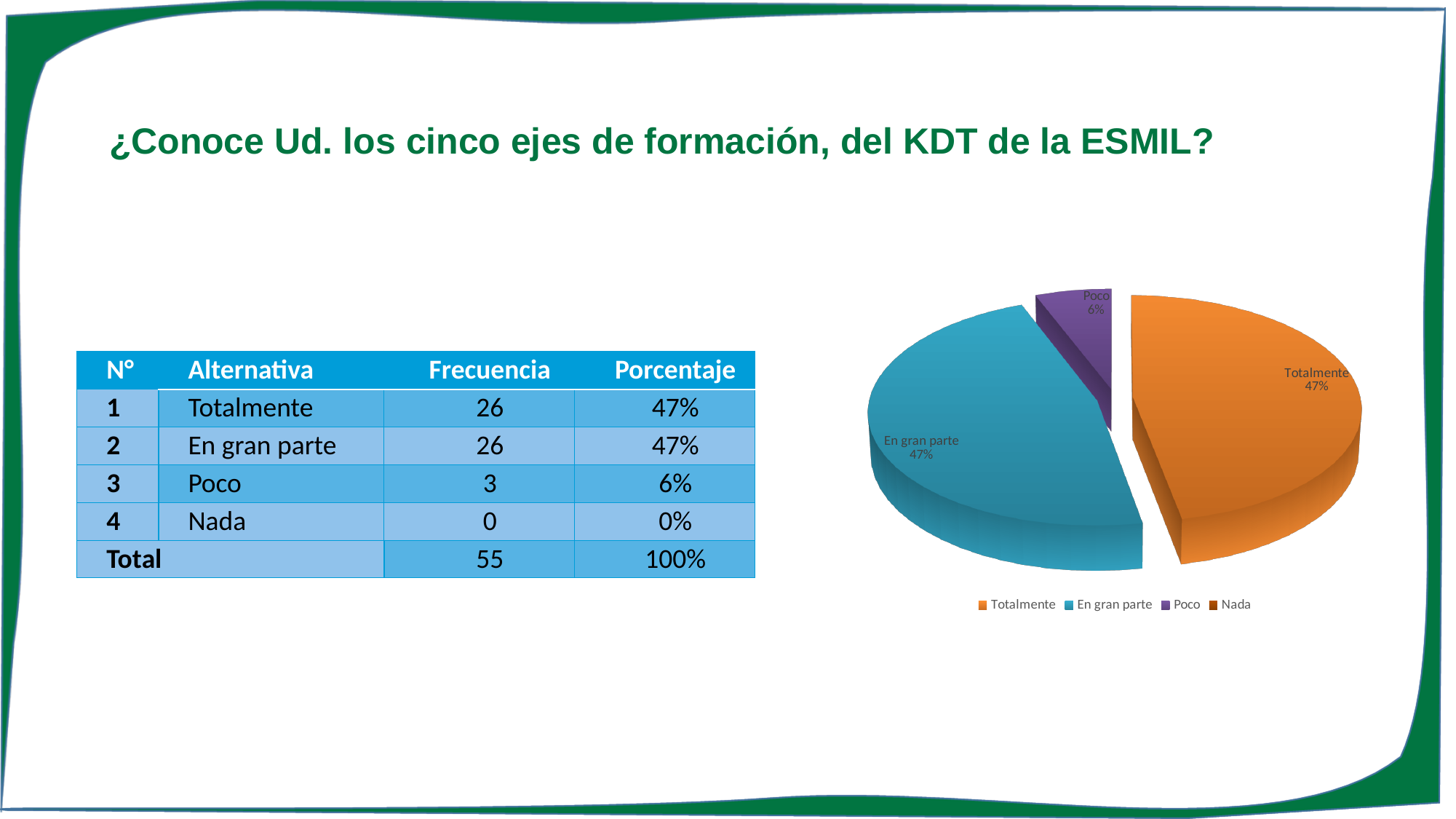
Which category has the smallest visible slice in the pie chart? Poco What is the combined share of Totalmente and En gran parte in the pie chart? 94% What kind of chart is shown on the slide? pie chart How many entries does the pie chart's legend list? 4 What percentage does the pie chart show for Poco? 6% What percentage does the pie chart show for En gran parte? 47% Which legend entry has no visible slice in the pie chart? Nada What colour is the Totalmente slice in the pie chart? orange What percentage does the pie chart show for Totalmente? 47% Is the slice for Poco larger or smaller than the slice for En gran parte? smaller What is the difference in percentage between Totalmente and Poco in the pie chart? 41%